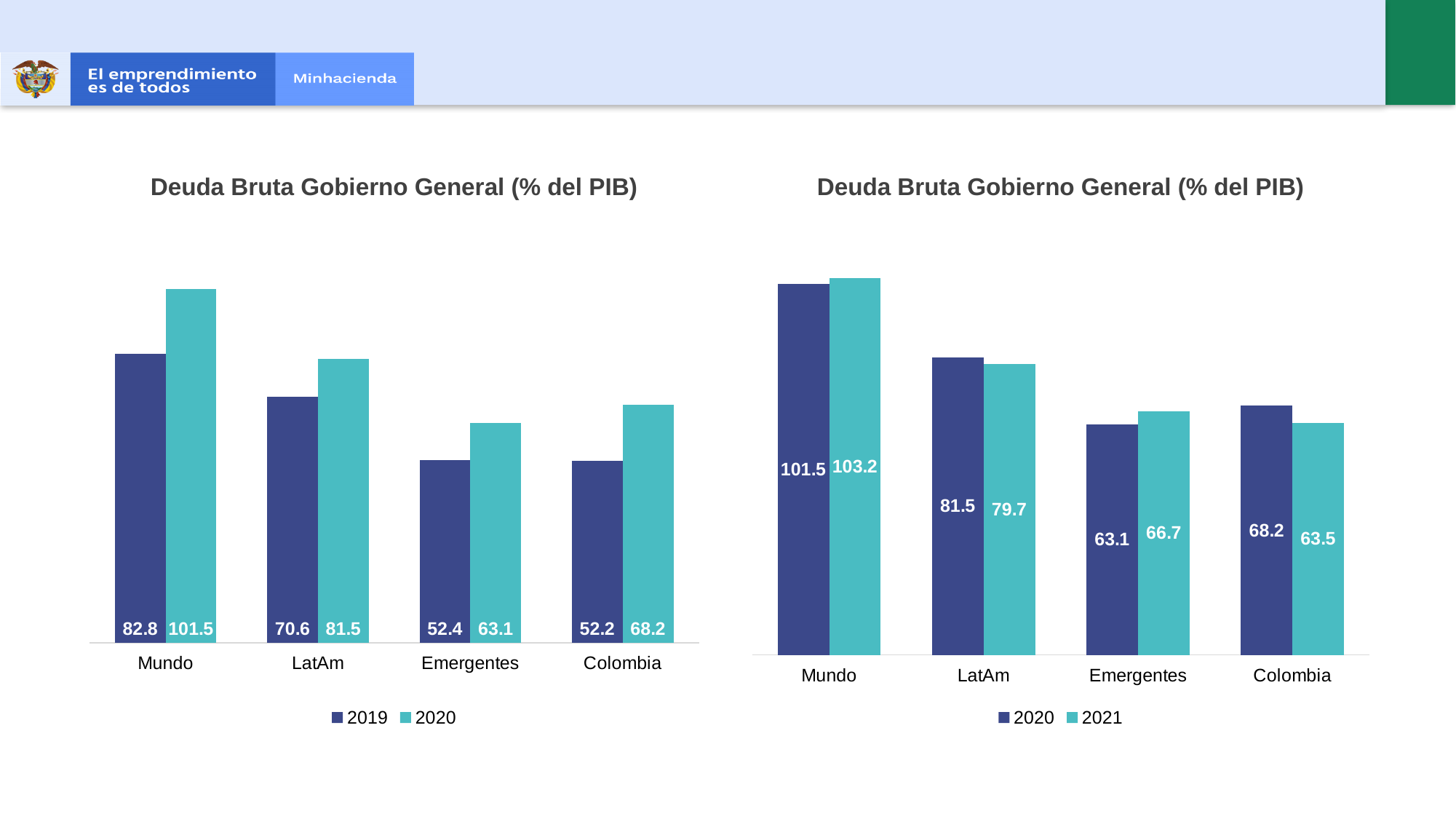
What kind of chart is the left chart? Bar chart How many categories are shown on the x axis of the left chart? 4 In the left chart, what is the difference between the 2020 and 2019 values for Mundo? 18.7 How many series does the legend of the right chart list? 2 In the right chart, which is larger for Emergentes: the 2020 value or the 2021 value? 2021 In the left chart, what is the 2020 value for Colombia? 68.2 In the left chart, which category has the highest 2020 value? Mundo In the left chart, what is the 2019 value for Emergentes? 52.4 In the right chart, what is the 2021 value for LatAm? 79.7 What are the two series listed in the legend of the right chart? 2020 and 2021 In the right chart, what is the difference between the 2020 and 2021 values for Colombia? 4.7 In the right chart, which category has the lowest 2021 value? Colombia